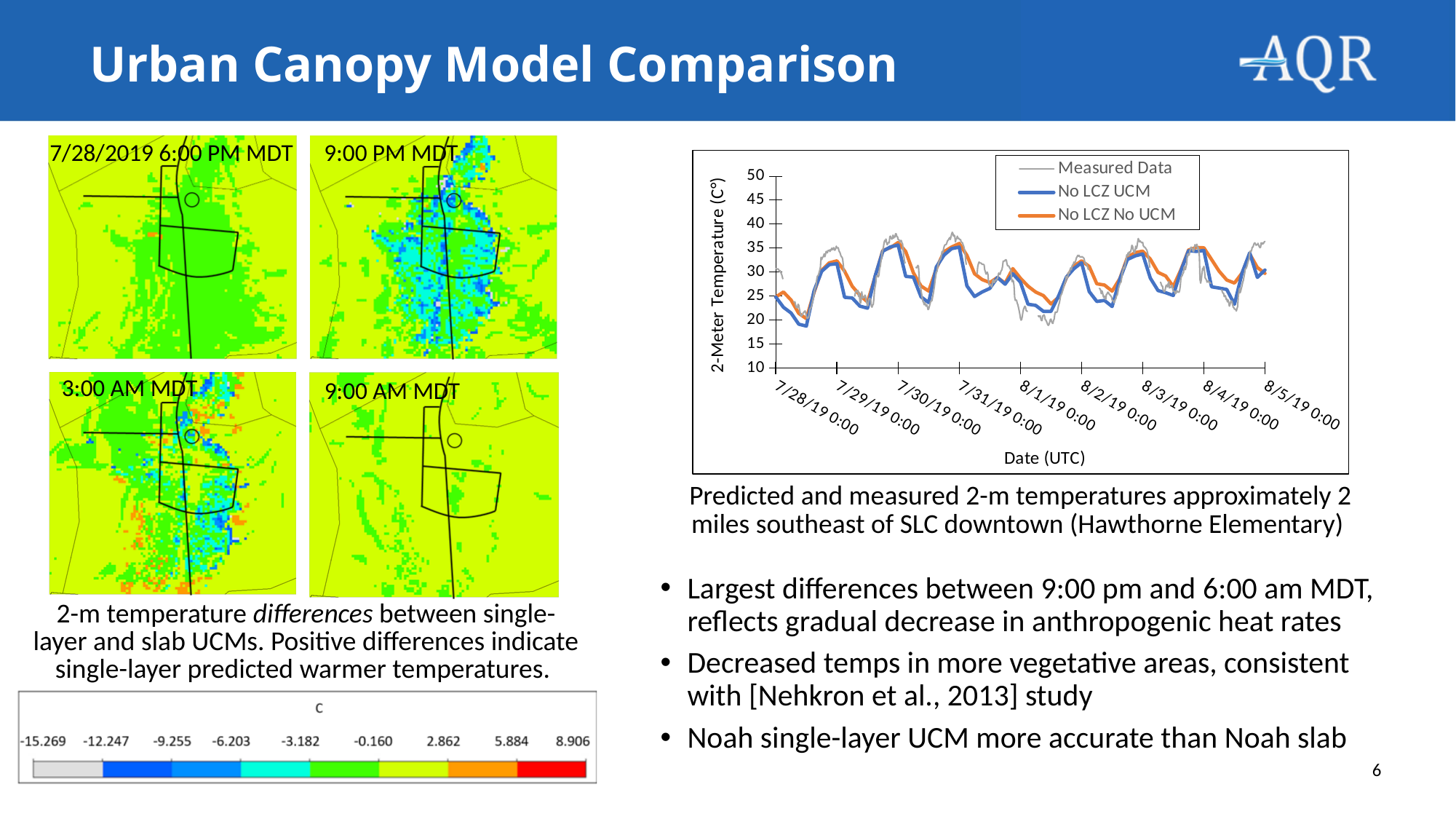
In the temperature chart, is the peak of the Measured Data around 7/30/19 greater or less than 35? greater How many series does the legend of the temperature chart list? 3 In the temperature chart, is the lowest No LCZ UCM value between 7/28/19 0:00 and 7/29/19 0:00 greater or less than 25? less What is the highest value shown on the y axis of the temperature chart? 50 What kind of chart is shown on the right side of the slide? line chart What are the three series listed in the legend of the temperature chart? Measured Data, No LCZ UCM, No LCZ No UCM In the temperature chart, is the No LCZ UCM value at 7/28/19 0:00 greater or less than 30? less What is the lowest value shown on the y axis of the temperature chart? 10 What is the first date label on the x axis of the temperature chart? 7/28/19 0:00 In the temperature chart, which series is drawn in orange? No LCZ No UCM How many date labels are shown along the x axis of the temperature chart? 9 What is the y-axis label of the temperature chart? 2-Meter Temperature (C°)